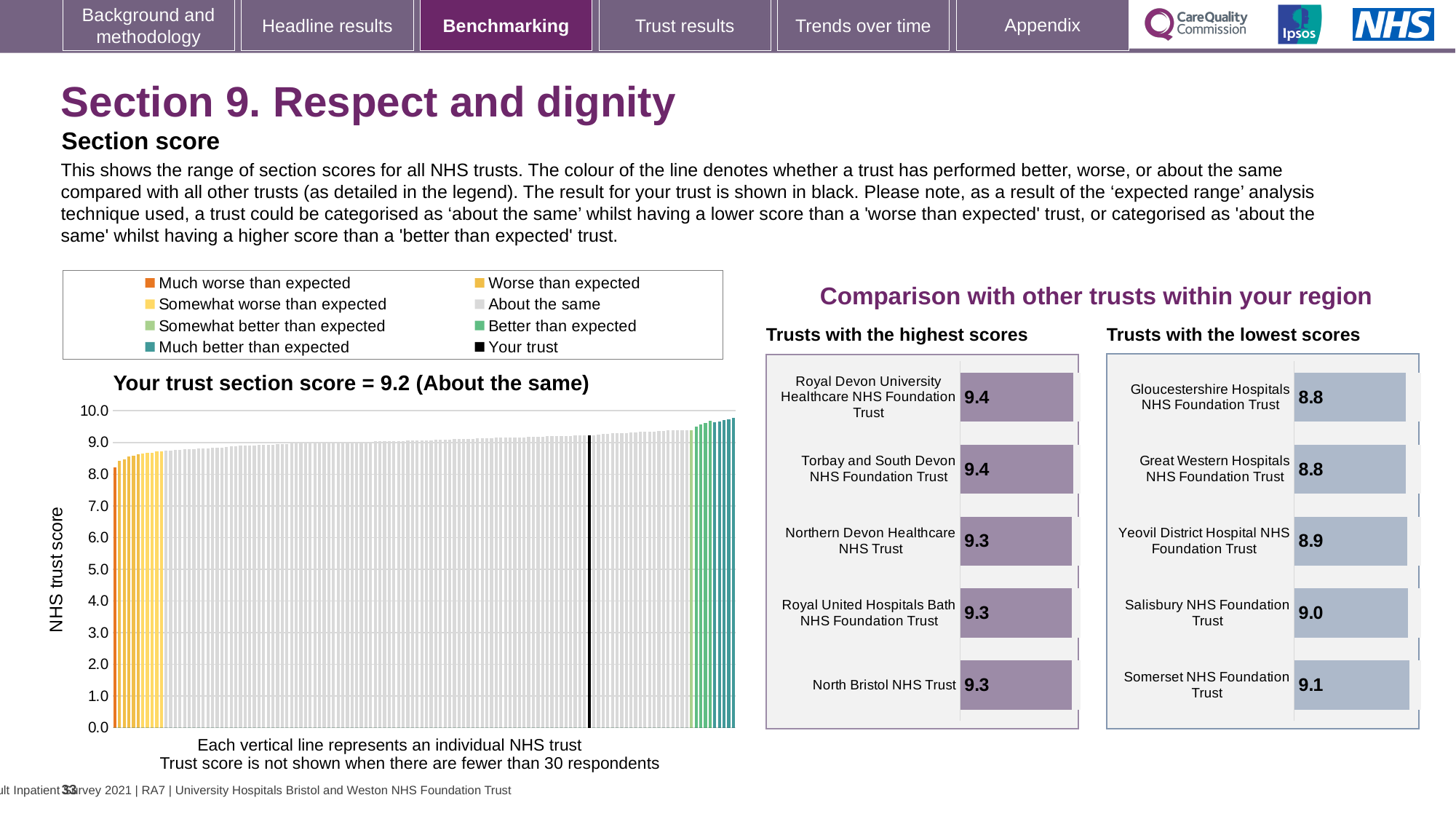
In the 'Trusts with the lowest scores' chart, which trust has the highest score? Somerset NHS Foundation Trust In the 'Trusts with the highest scores' chart, which has the larger score: Torbay and South Devon NHS Foundation Trust or North Bristol NHS Trust? Torbay and South Devon NHS Foundation Trust What is the y-axis label of the chart titled 'Your trust section score = 9.2 (About the same)'? NHS trust score In the chart titled 'Your trust section score = 9.2 (About the same)', do the bar values rise or fall from left to right along the x axis? rise What kind of chart is the chart titled 'Your trust section score = 9.2 (About the same)'? bar chart In the 'Trusts with the highest scores' chart, what is the score for Royal Devon University Healthcare NHS Foundation Trust? 9.4 How many entries does the legend above the 'Your trust section score' chart list? 8 In the 'Trusts with the highest scores' chart, how many trusts are shown? 5 In the 'Trusts with the lowest scores' chart, what is the difference between the scores of Somerset NHS Foundation Trust and Gloucestershire Hospitals NHS Foundation Trust? 0.3 In the chart titled 'Your trust section score = 9.2 (About the same)', what is the section score for your trust? 9.2 In the 'Trusts with the highest scores' chart, what is the score for Northern Devon Healthcare NHS Trust? 9.3 In the 'Trusts with the lowest scores' chart, what is the score for Salisbury NHS Foundation Trust? 9.0